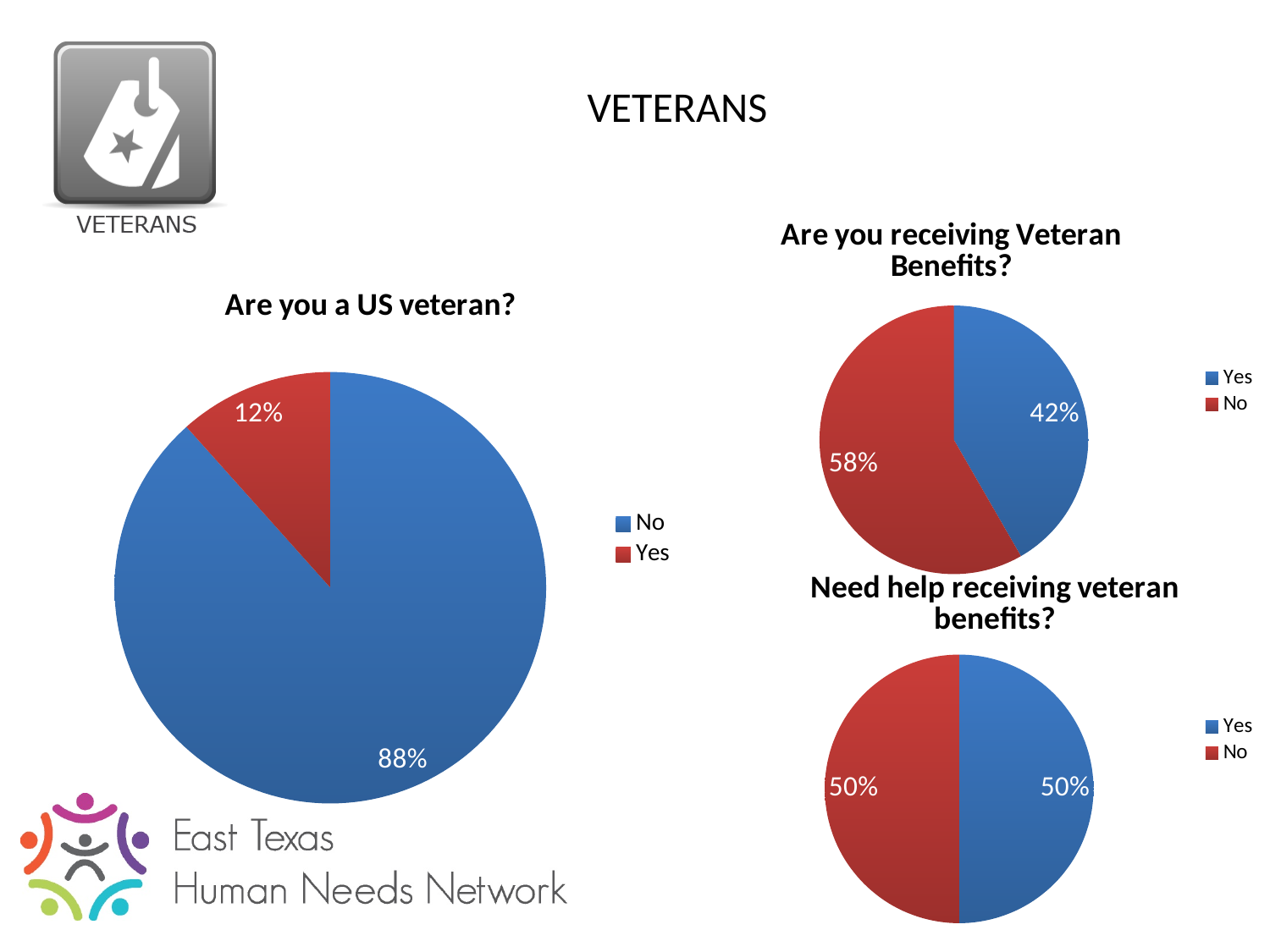
In the 'Are you receiving Veteran Benefits?' chart, which response has the smallest share? Yes In the 'Are you receiving Veteran Benefits?' chart, what percentage answered No? 58% In the 'Are you a US veteran?' chart, what percentage answered Yes? 12% How many entries does the legend of the 'Are you a US veteran?' chart list? 2 In the 'Are you a US veteran?' chart, which response has the largest share? No In the 'Are you receiving Veteran Benefits?' chart, what percentage answered Yes? 42% In the 'Are you receiving Veteran Benefits?' chart, which is larger, Yes or No? No In the 'Are you a US veteran?' chart, what percentage answered No? 88% In the 'Are you receiving Veteran Benefits?' chart, what is the difference between the No and Yes shares? 16% In the 'Need help receiving veteran benefits?' chart, what percentage answered Yes? 50% In the 'Are you a US veteran?' chart, what is the difference between the No and Yes shares? 76% What type of chart is used for 'Need help receiving veteran benefits?' Pie chart